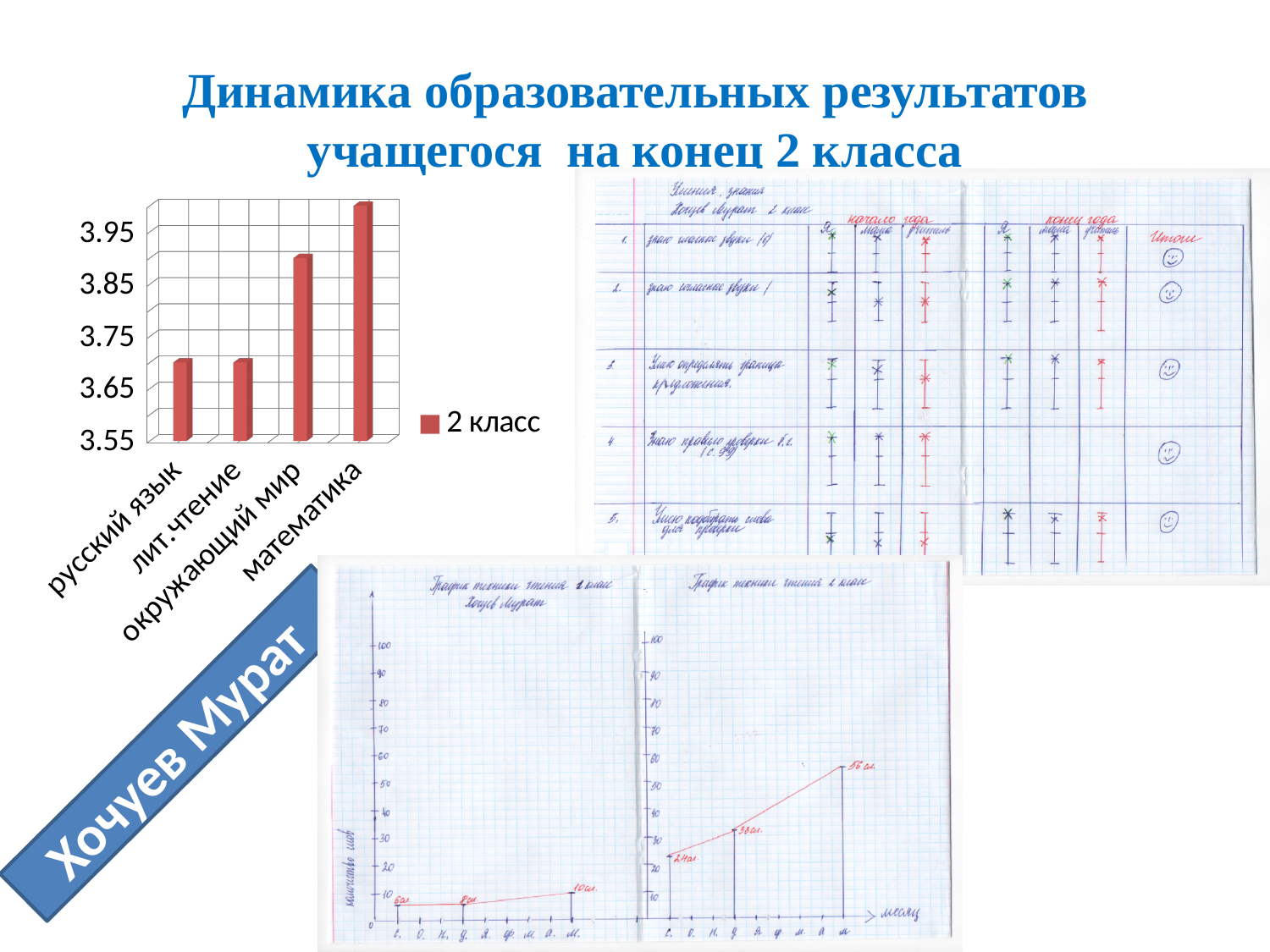
In the bar chart on the left, which is larger: the value for окружающий мир or the value for лит.чтение? окружающий мир In the bar chart on the left, which subject has the highest value? математика In the bar chart on the left, is the value for математика greater or less than 3.95? greater In the bar chart on the left, is the value for русский язык greater or less than 3.75? less In the bar chart on the left, which is larger: the value for математика or the value for русский язык? математика How many subjects are shown in the bar chart on the left? 4 In the bar chart on the left, is the value for окружающий мир greater or less than 3.85? greater How many series does the legend of the bar chart on the left list? 1 What is the legend entry of the bar chart on the left? 2 класс What kind of chart is shown on the left of the slide? bar chart